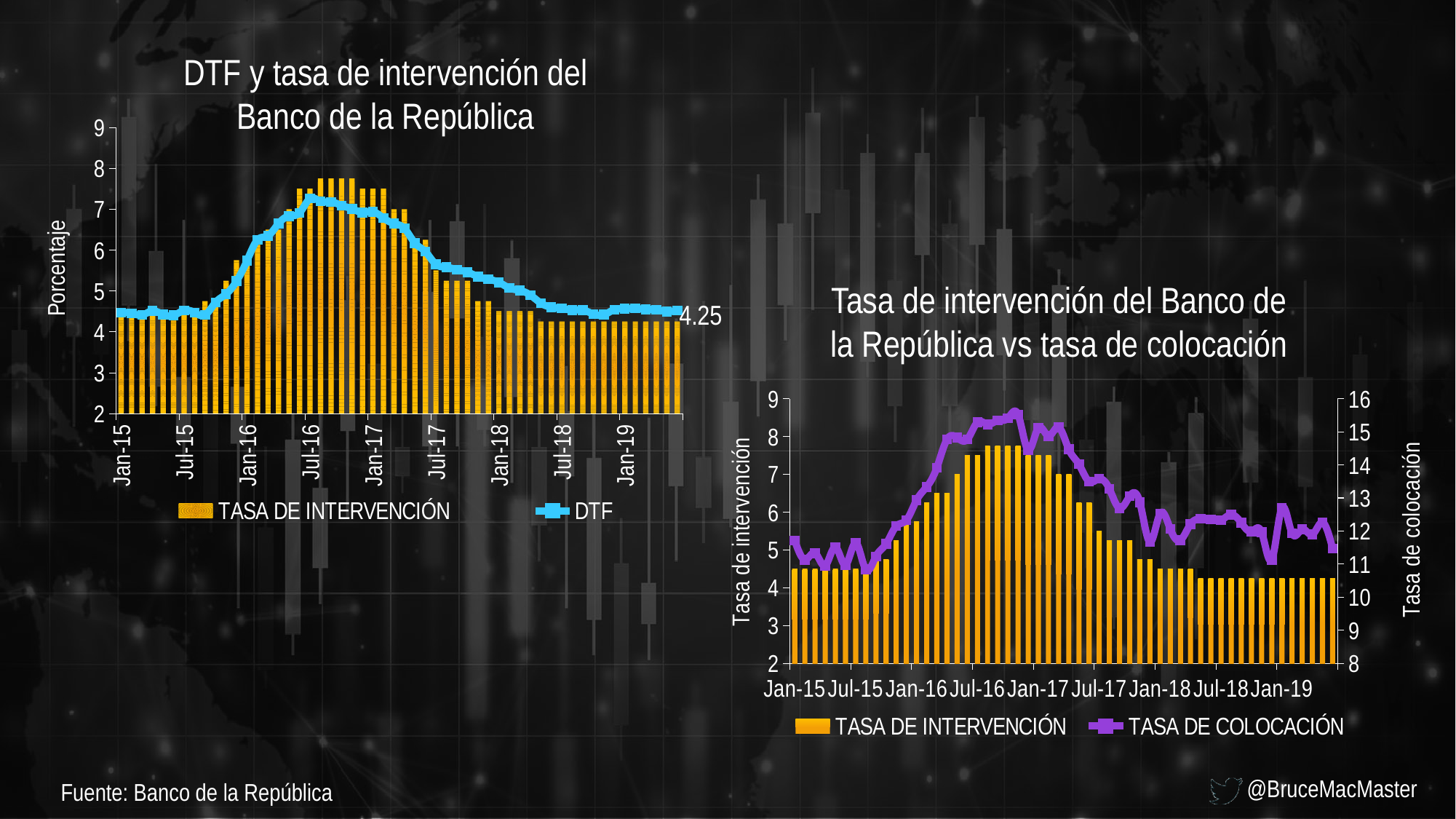
In the right chart, 'Tasa de intervención del Banco de la República vs tasa de colocación', what is the title of the right-hand vertical axis? Tasa de colocación In the right chart, 'Tasa de intervención del Banco de la República vs tasa de colocación', is the tasa de colocación at Jan-19 greater or less than 14 on the right axis? less In the left chart, 'DTF y tasa de intervención del Banco de la República', what is the value printed at the end of the DTF line? 4.25 In the left chart, 'DTF y tasa de intervención del Banco de la República', what are the two legend entries? TASA DE INTERVENCIÓN and DTF How many series does the legend of the left chart, 'DTF y tasa de intervención del Banco de la República', list? 2 In the left chart, 'DTF y tasa de intervención del Banco de la República', is the tasa de intervención at Jan-16 greater or less than 5? greater In the left chart, 'DTF y tasa de intervención del Banco de la República', is the DTF value at Jan-15 greater or less than 6? less In the left chart, 'DTF y tasa de intervención del Banco de la República', does the DTF line rise or fall from Jan-17 to Jan-19? fall What kind of chart is the left chart, 'DTF y tasa de intervención del Banco de la República'? Combined bar and line chart How many series does the legend of the right chart, 'Tasa de intervención del Banco de la República vs tasa de colocación', list? 2